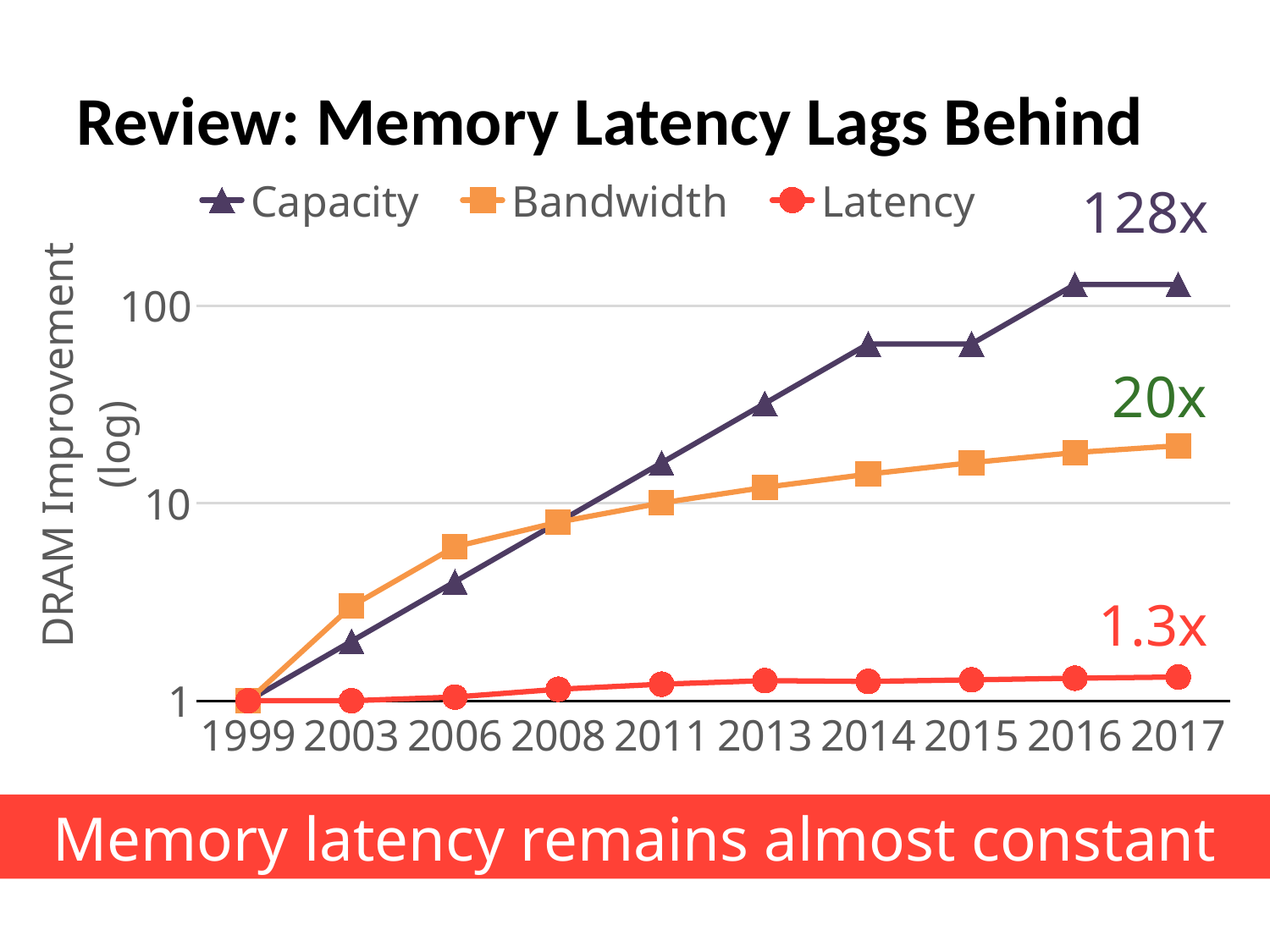
What is the Latency improvement value labelled at 2017? 1.3x In 2006, which is larger: Bandwidth or Capacity? Bandwidth Does the Capacity series rise or fall from 1999 to 2017? rise What kind of chart is shown on the slide? line chart How many years are plotted along the x axis? 10 How many series does the legend list? 3 Which series has the highest value in 2017? Capacity What is the title of the y axis? DRAM Improvement (log) Is the Capacity value for 2014 greater or less than 100? less Which series has the lowest value in 2017? Latency What is the Capacity improvement value labelled at 2017? 128x What is the Bandwidth improvement value labelled at 2017? 20x